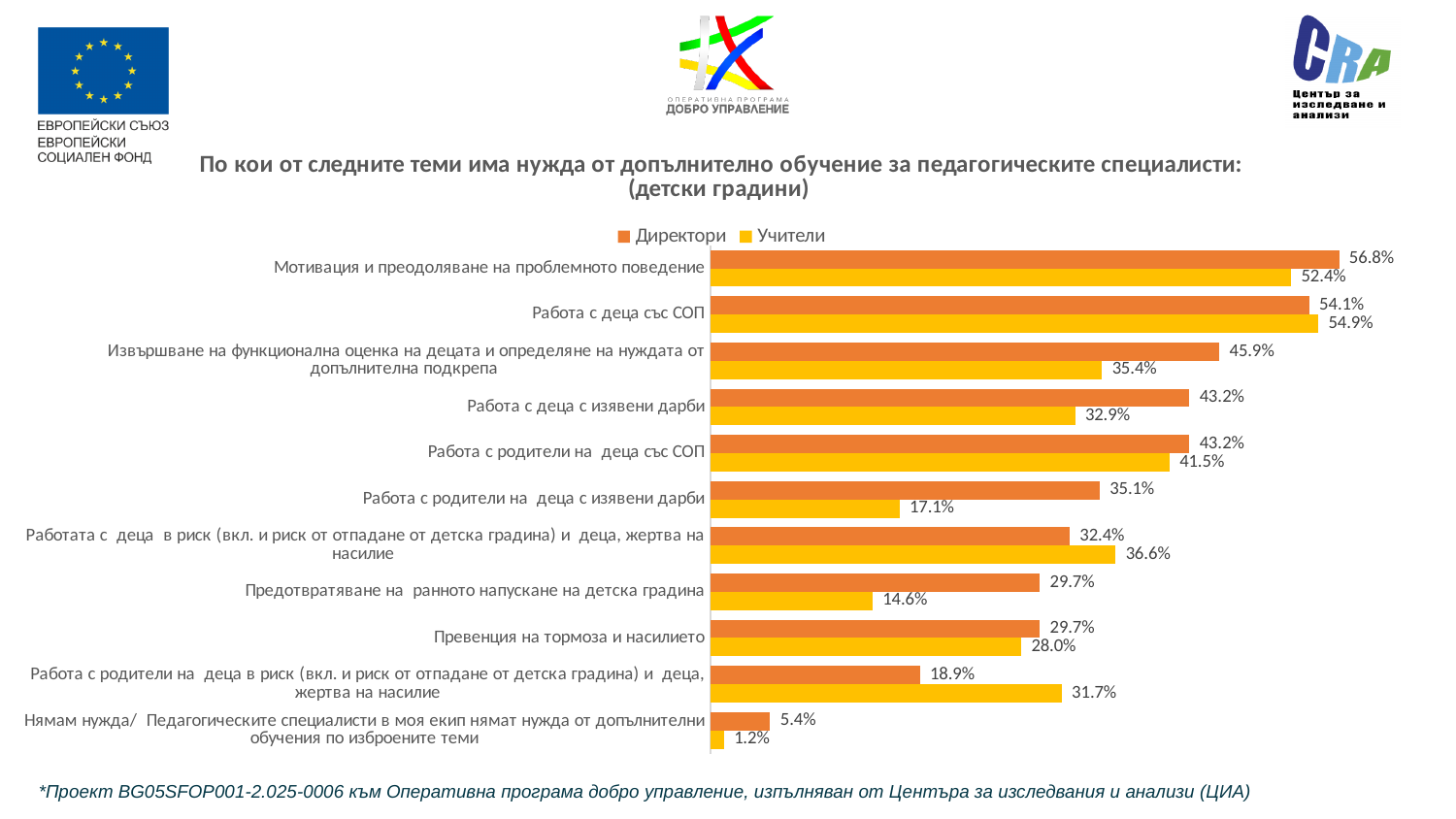
What is the difference between the Директори and Учители values for 'Извършване на функционална оценка на децата и определяне на нуждата от допълнителна подкрепа'? 10.5% Which category has the highest value for Директори? Мотивация и преодоляване на проблемното поведение For 'Работа с родители на деца в риск (вкл. и риск от отпадане от детска градина) и деца, жертва на насилие', which series has the larger value, Директори or Учители? Учители How many categories (topics) are shown in the chart? 11 What type of chart is shown on the slide? bar chart What is the value for Учители for 'Предотвратяване на ранното напускане на детска градина'? 14.6% What is the value for Директори for 'Мотивация и преодоляване на проблемното поведение'? 56.8% How many series does the legend list? 2 What is the value for Учители for 'Работа с деца със СОП'? 54.9% What is the difference between the Директори and Учители values for 'Работа с родители на деца с изявени дарби'? 18.0% Which category has the lowest value for Учители? Нямам нужда/ Педагогическите специалисти в моя екип нямат нужда от допълнителни обучения по изброените теми Which colour represents the Учители series in the chart? yellow